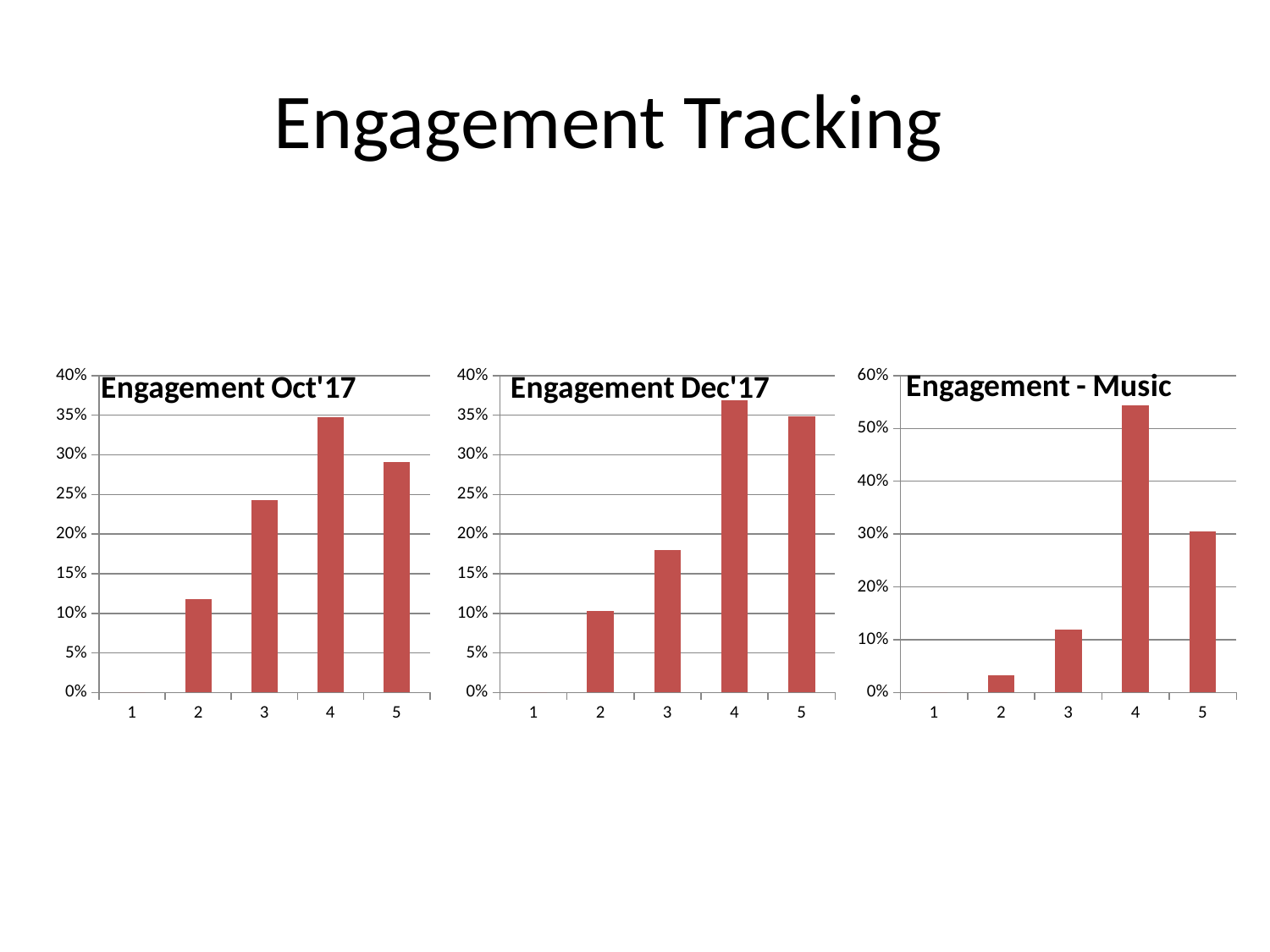
In the "Engagement Oct'17" chart, which is larger, the value for category 3 or category 5? 5 What is the highest value shown on the y axis of the "Engagement - Music" chart? 60% In the "Engagement Oct'17" chart, is the value for category 2 greater or less than 15%? less In the "Engagement Dec'17" chart, is the value for category 3 greater or less than 15%? greater What type of chart is "Engagement Oct'17"? bar chart In the "Engagement Oct'17" chart, is the value for category 3 greater or less than 20%? greater In the "Engagement - Music" chart, which category has the highest value? 4 How many categories are shown on the x axis of the "Engagement Dec'17" chart? 5 In the "Engagement Oct'17" chart, which category has the highest value? 4 In the "Engagement Dec'17" chart, which is larger, the value for category 2 or category 5? 5